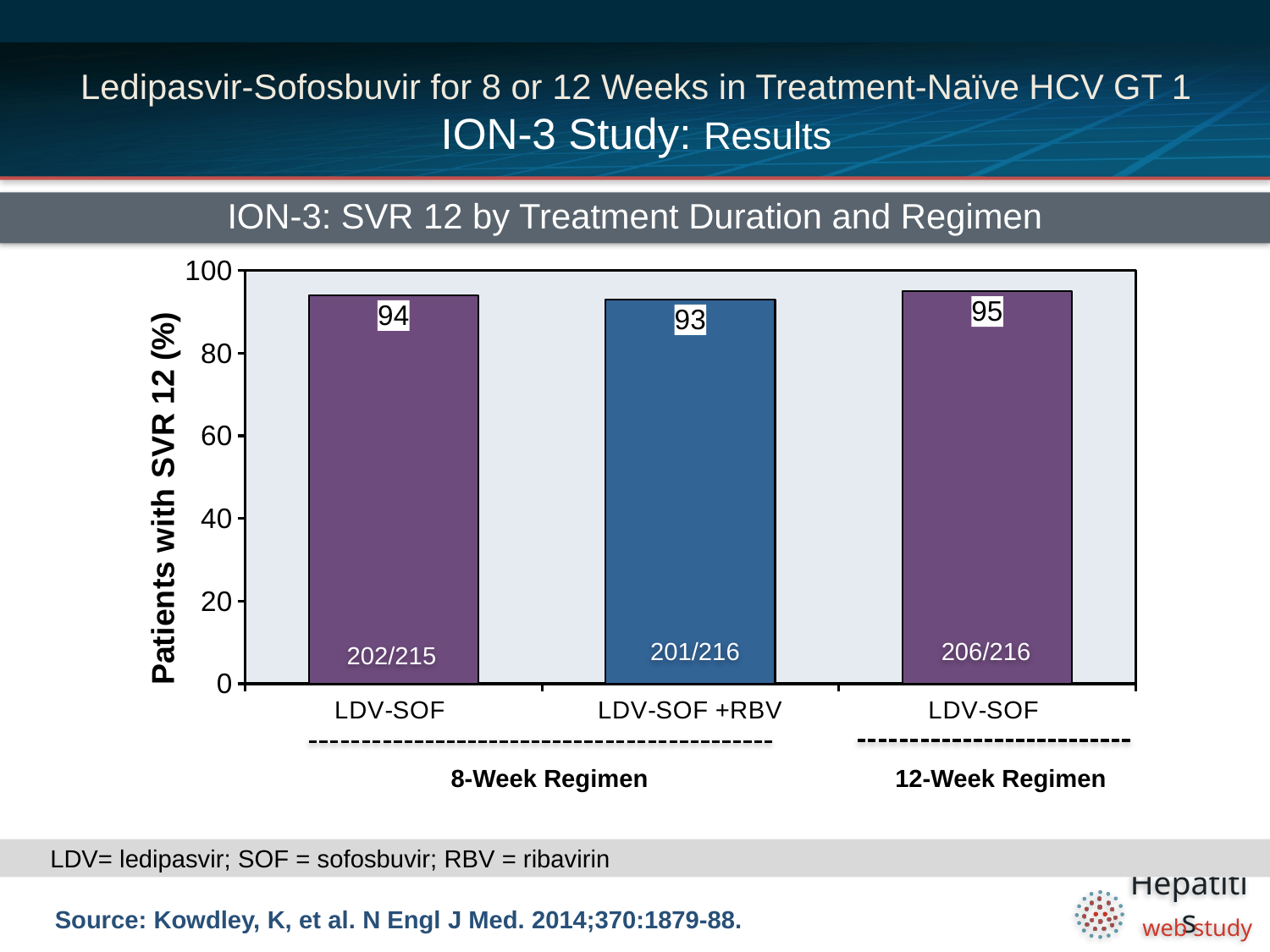
What fraction is printed on the LDV-SOF +RBV bar? 201/216 What is the SVR 12 rate for LDV-SOF in the 8-week regimen? 94 How many patients achieved SVR 12 out of the total in the 12-week LDV-SOF group, as printed on the bar? 206/216 How many bars are shown in the chart? 3 What type of chart is shown on the slide? Bar chart What is the difference in SVR 12 rate between the 12-week LDV-SOF group and the 8-week LDV-SOF +RBV group? 2 Which bar has the lowest SVR 12 rate? LDV-SOF +RBV, 8-Week Regimen Which has a higher SVR 12 rate: 8-week LDV-SOF or 8-week LDV-SOF +RBV? 8-week LDV-SOF Which bar has the highest SVR 12 rate? LDV-SOF, 12-Week Regimen What is the label of the y-axis? Patients with SVR 12 (%) What is the SVR 12 rate for LDV-SOF in the 12-week regimen? 95 What is the SVR 12 rate for LDV-SOF +RBV in the 8-week regimen? 93